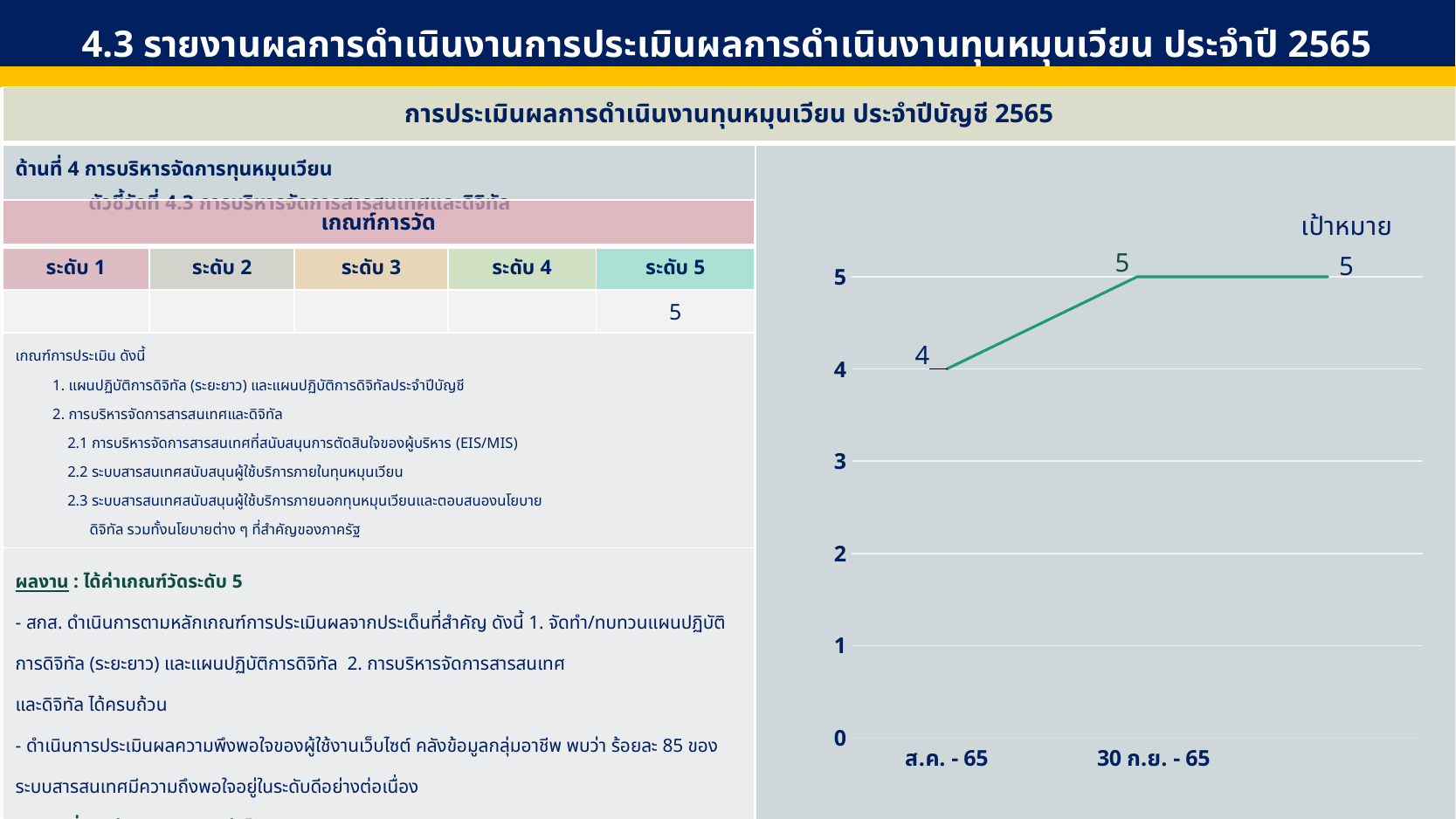
What is the difference between the value for 30 ก.ย. - 65 and the value for ส.ค. - 65 in the line chart? 1 What type of chart is shown on the right side of the slide? line chart Is the value for ส.ค. - 65 in the line chart greater or less than 3? greater Which point on the line chart has the lowest value? ส.ค. - 65 What colour is the line in the chart? green Does the line in the chart rise or fall from ส.ค. - 65 to 30 ก.ย. - 65? rise What is the value shown for เป้าหมาย in the line chart? 5 What is the value plotted for ส.ค. - 65 in the line chart? 4 Which is larger in the line chart, the value for ส.ค. - 65 or the value for 30 ก.ย. - 65? 30 ก.ย. - 65 What is the highest value shown on the y-axis of the line chart? 5 What is the value plotted for 30 ก.ย. - 65 in the line chart? 5 How many data points are plotted on the line chart? 3